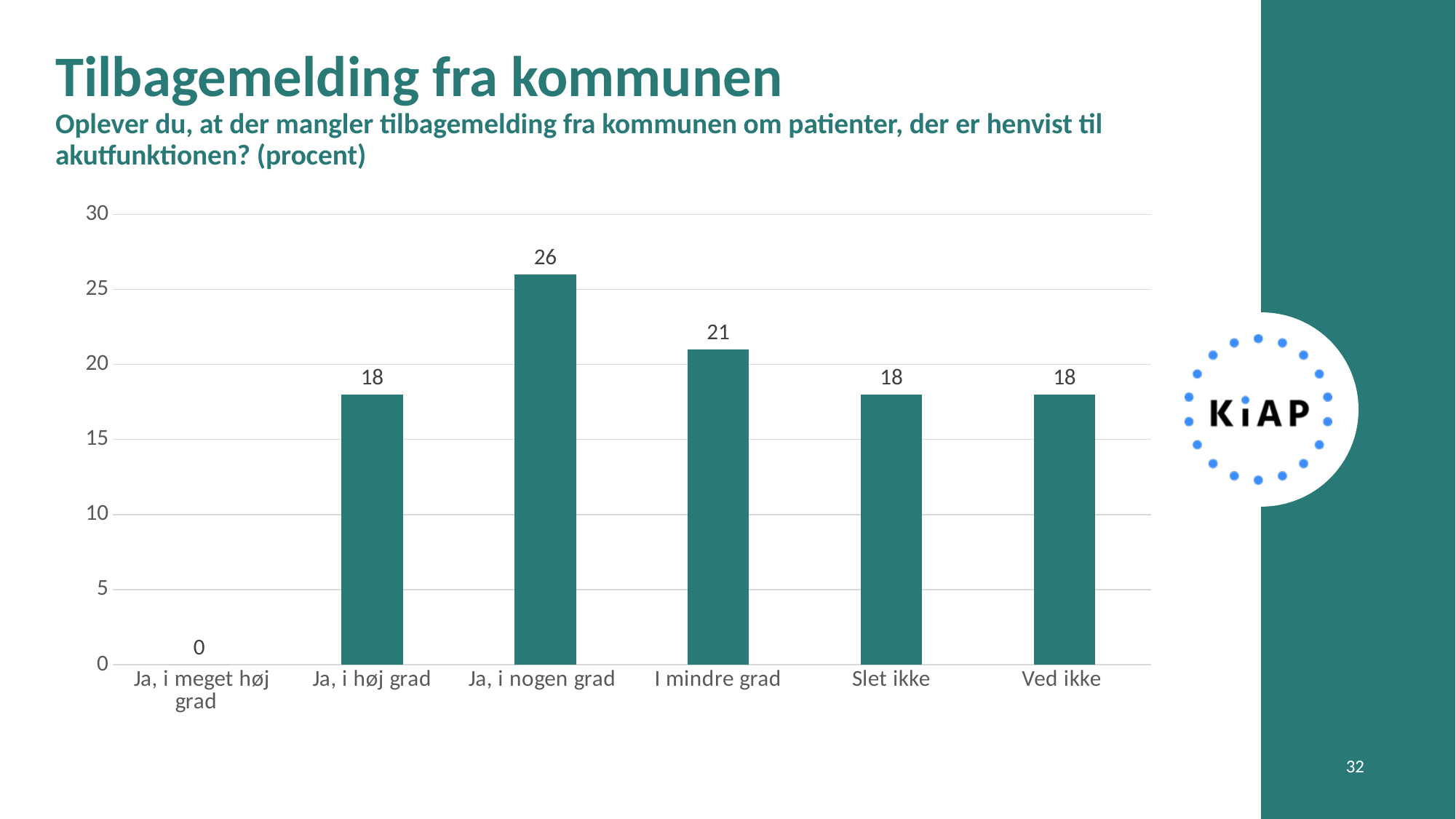
What kind of chart is shown on the slide? bar chart Which is larger, the value for "Ja, i nogen grad" or the value for "Ja, i høj grad"? Ja, i nogen grad What is the value for "Ja, i nogen grad"? 26 What is the difference between the values for "I mindre grad" and "Slet ikke"? 3 Is the value for "Ja, i nogen grad" greater or less than 25? greater How many categories are shown on the x axis? 6 What is the value for "Ja, i meget høj grad"? 0 What is the value for "I mindre grad"? 21 Which category has the highest value? Ja, i nogen grad What is the value for "Ved ikke"? 18 What is the difference between the values for "Ja, i nogen grad" and "I mindre grad"? 5 Which category has the lowest value? Ja, i meget høj grad